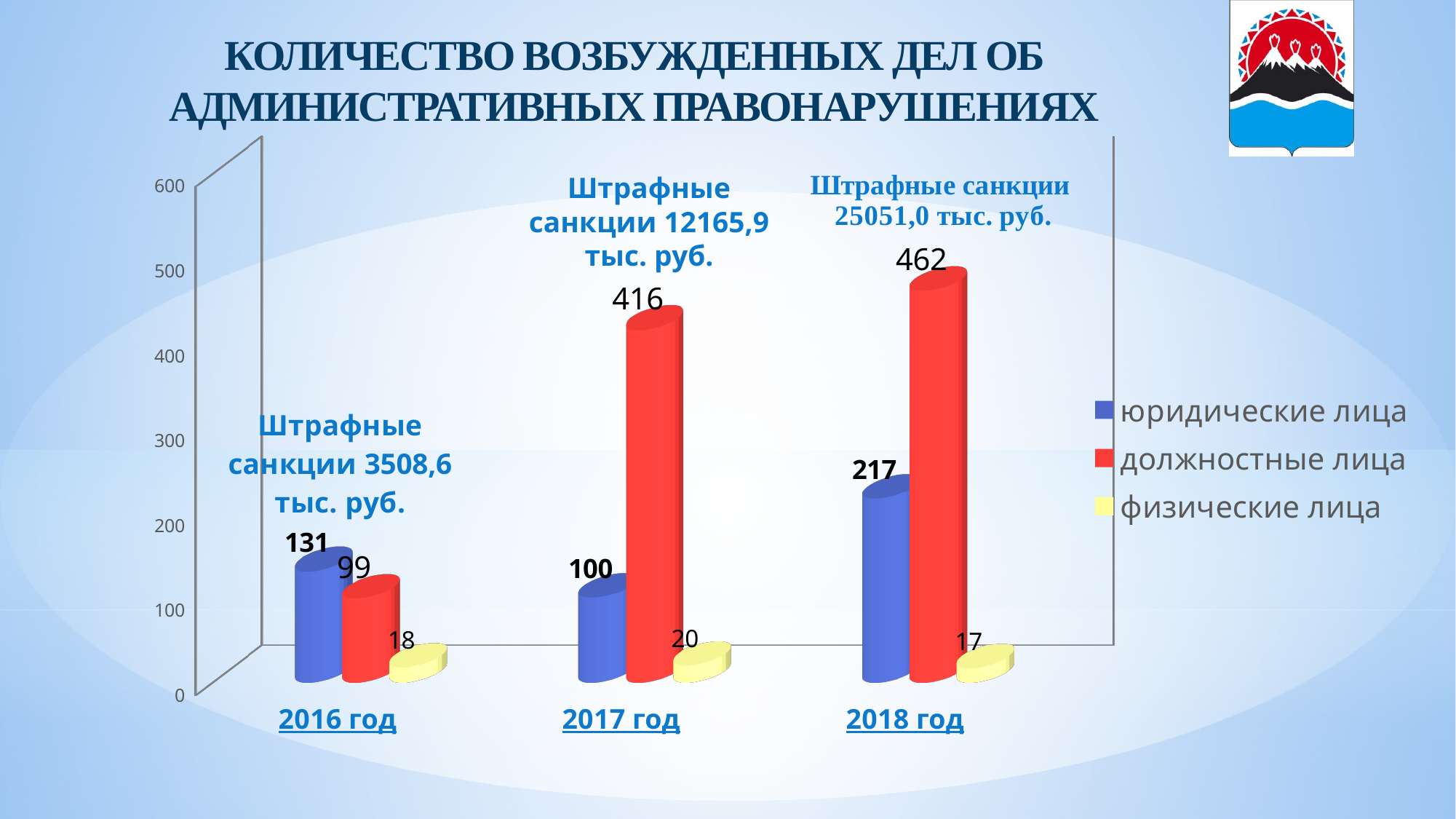
How many series does the legend list? 3 What is the value for физические лица in 2017 год? 20 Which year has the highest value for должностные лица? 2018 год Do the values for должностные лица rise or fall from 2016 год to 2018 год? rise Which is larger: юридические лица in 2016 год or должностные лица in 2016 год? юридические лица in 2016 год What amount of штрафные санкции is annotated for 2017 год? 12165,9 тыс. руб. How many year categories are shown on the x axis? 3 What is the difference between должностные лица in 2018 год and 2017 год? 46 What is the value for юридические лица in 2016 год? 131 What is the value for должностные лица in 2018 год? 462 Which year has the lowest value for юридические лица? 2017 год What kind of chart is shown on the slide? bar chart